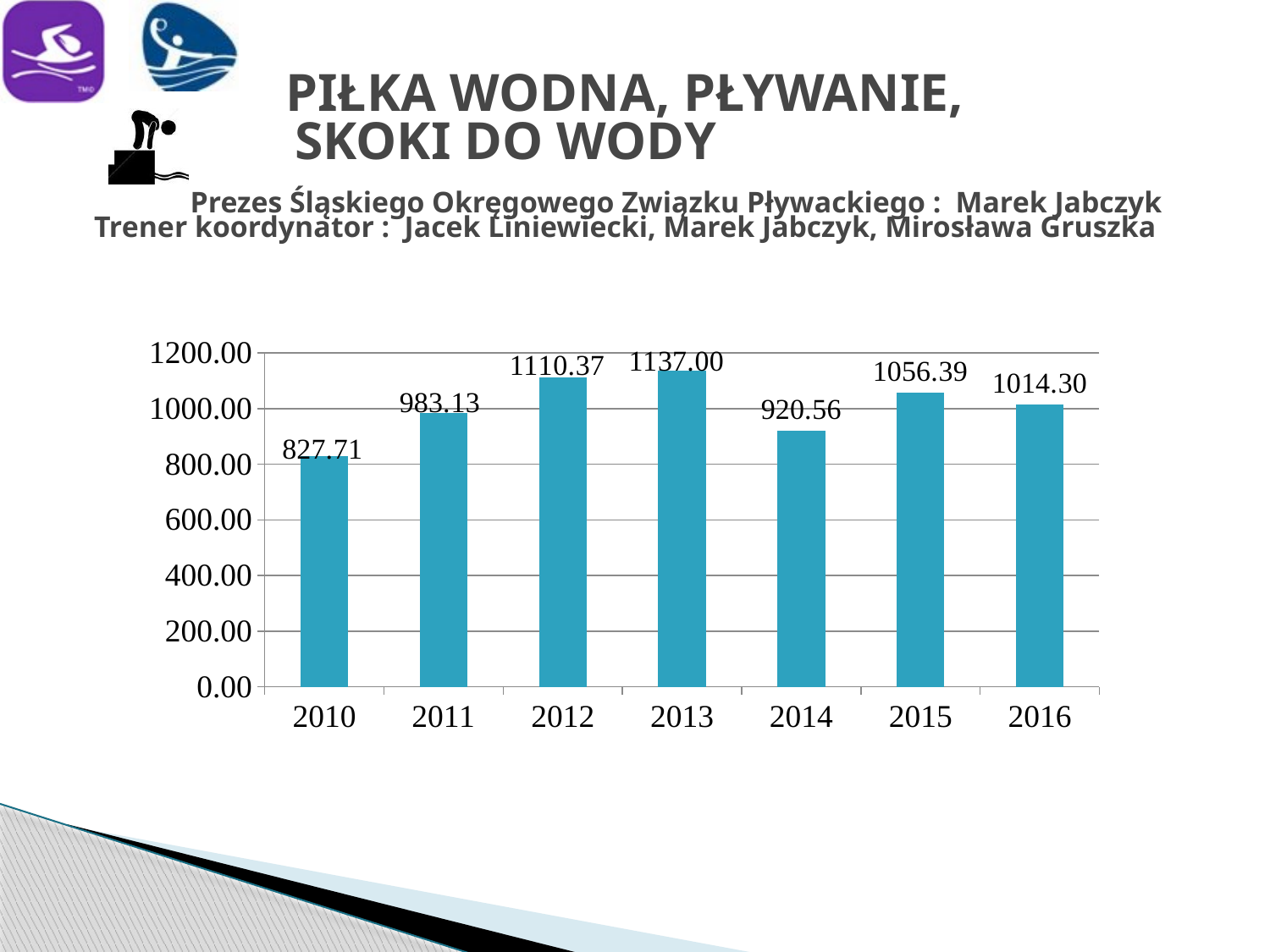
What is the value for 2016? 1014.30 Which is larger, the value for 2012 or the value for 2015? 2012 What is the difference between the values for 2015 and 2014? 135.83 What is the difference between the values for 2016 and 2010? 186.59 How many years are shown on the x axis? 7 Do the values rise or fall from 2010 to 2013? rise What is the value for 2013? 1137.00 What is the value for 2010? 827.71 Which year has the highest value? 2013 What kind of chart is shown on the slide? bar chart Which year has the lowest value? 2010 Is the value for 2014 greater or less than 1000.00? less